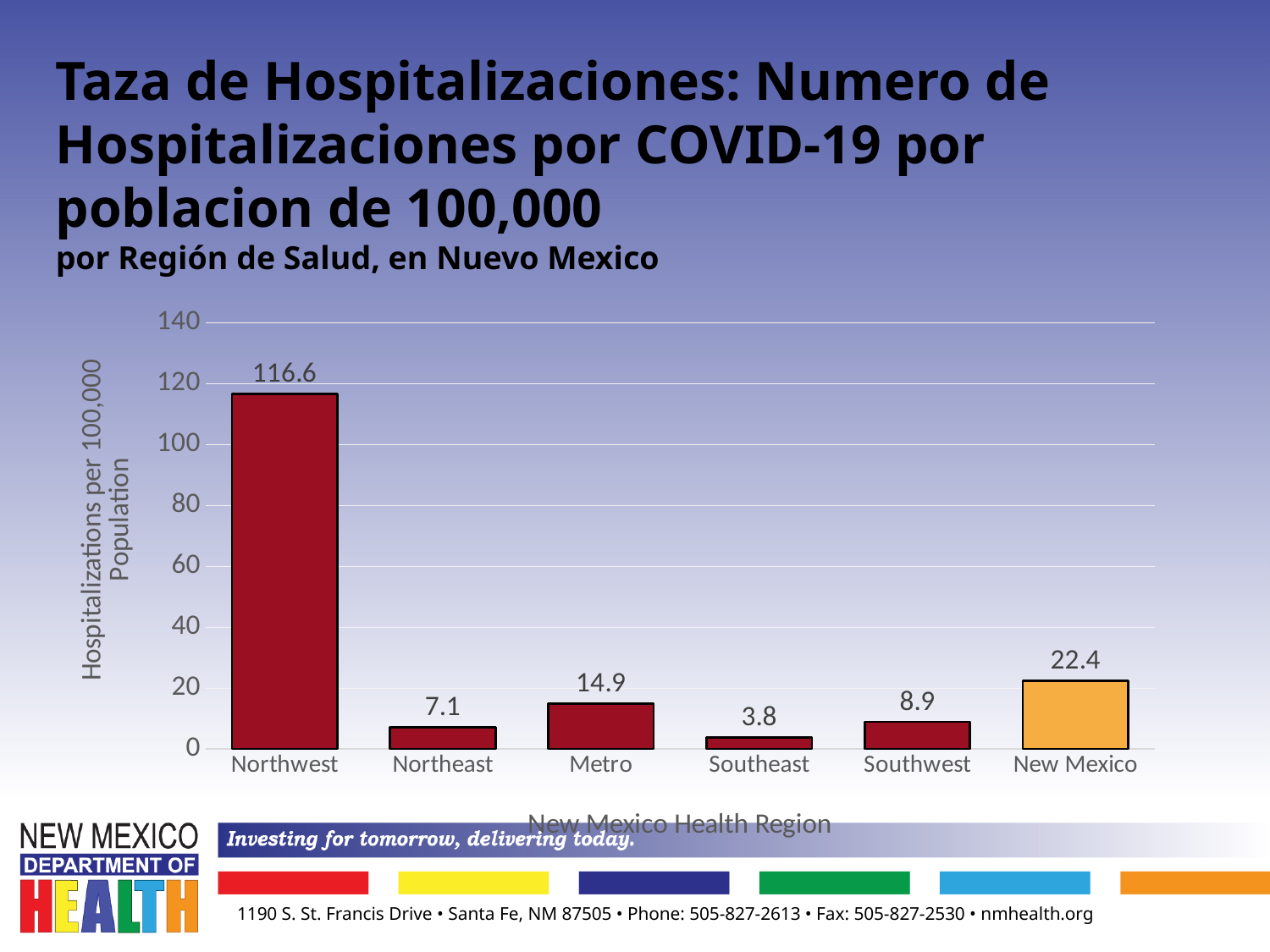
Which health region has the highest hospitalization rate? Northwest Which health region has the lowest hospitalization rate? Southeast What is the hospitalization rate per 100,000 population for the Northwest region? 116.6 Which has a higher hospitalization rate, Southwest or Northeast? Southwest What is the hospitalization rate per 100,000 population for the Metro region? 14.9 What kind of chart is shown on the slide? Bar chart Is the value for Northwest greater or less than 100? greater How many bars are shown in the chart? 6 What is the value shown for New Mexico overall? 22.4 What is the difference between the Metro rate and the Northeast rate? 7.8 What is the label of the vertical axis? Hospitalizations per 100,000 Population What is the difference between the Northwest rate and the New Mexico rate? 94.2